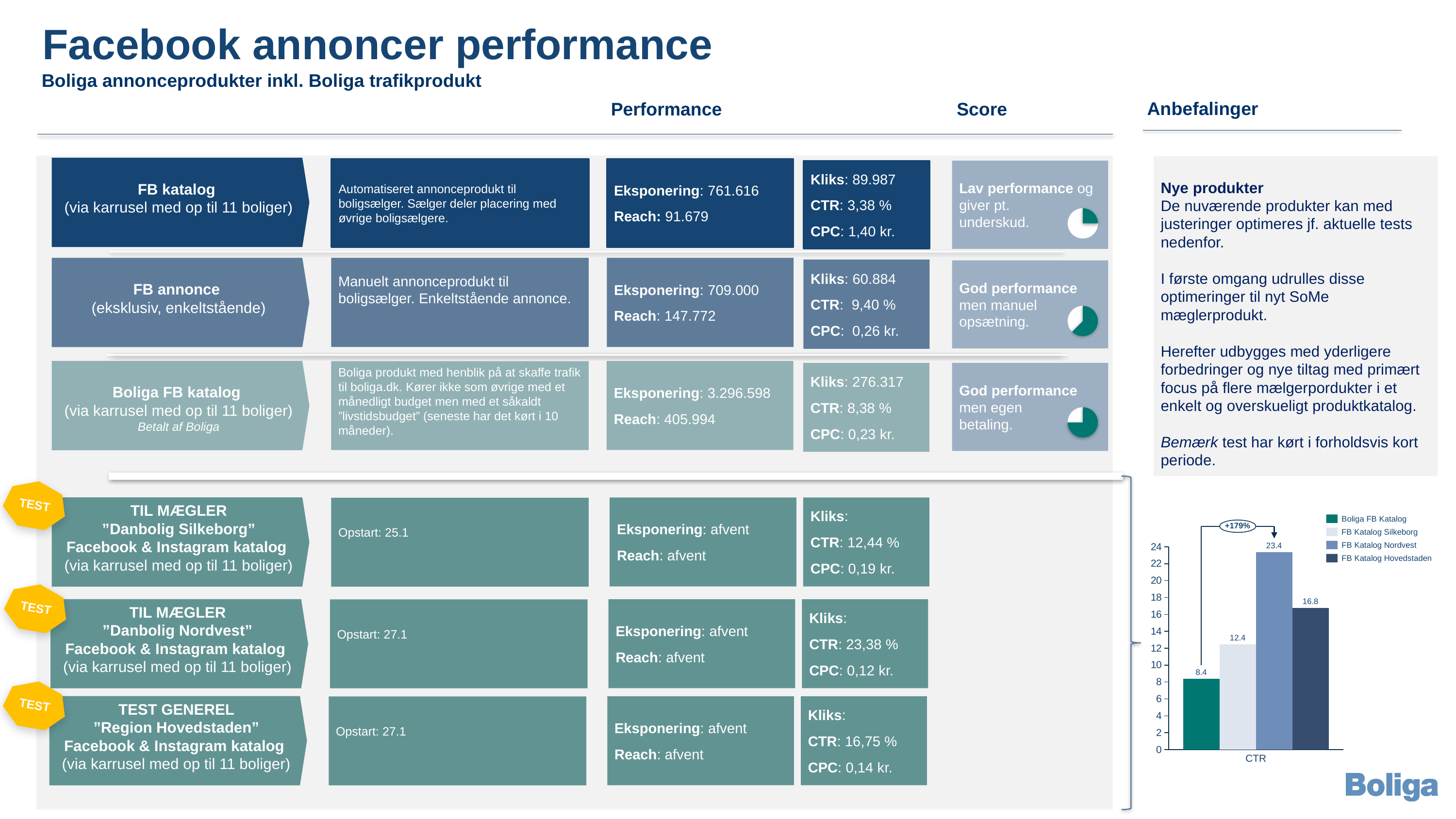
In the CTR bar chart, which is larger: FB Katalog Hovedstaden or FB Katalog Silkeborg? FB Katalog Hovedstaden How many series does the legend of the CTR bar chart list? 4 In the CTR bar chart, what is the value for FB Katalog Silkeborg? 12.4 In the CTR bar chart, what is the value for FB Katalog Hovedstaden? 16.8 In the CTR bar chart, what is the value for Boliga FB Katalog? 8.4 What percentage increase is annotated above the bars in the CTR bar chart? +179% What type of chart is shown at the bottom right of the slide? bar chart In the CTR bar chart, which series has the lowest value? Boliga FB Katalog In the CTR bar chart, what is the difference between FB Katalog Nordvest and Boliga FB Katalog? 15 In the CTR bar chart, what is the value for FB Katalog Nordvest? 23.4 In the CTR bar chart, which series has the highest value? FB Katalog Nordvest What is the category label on the x axis of the bar chart? CTR